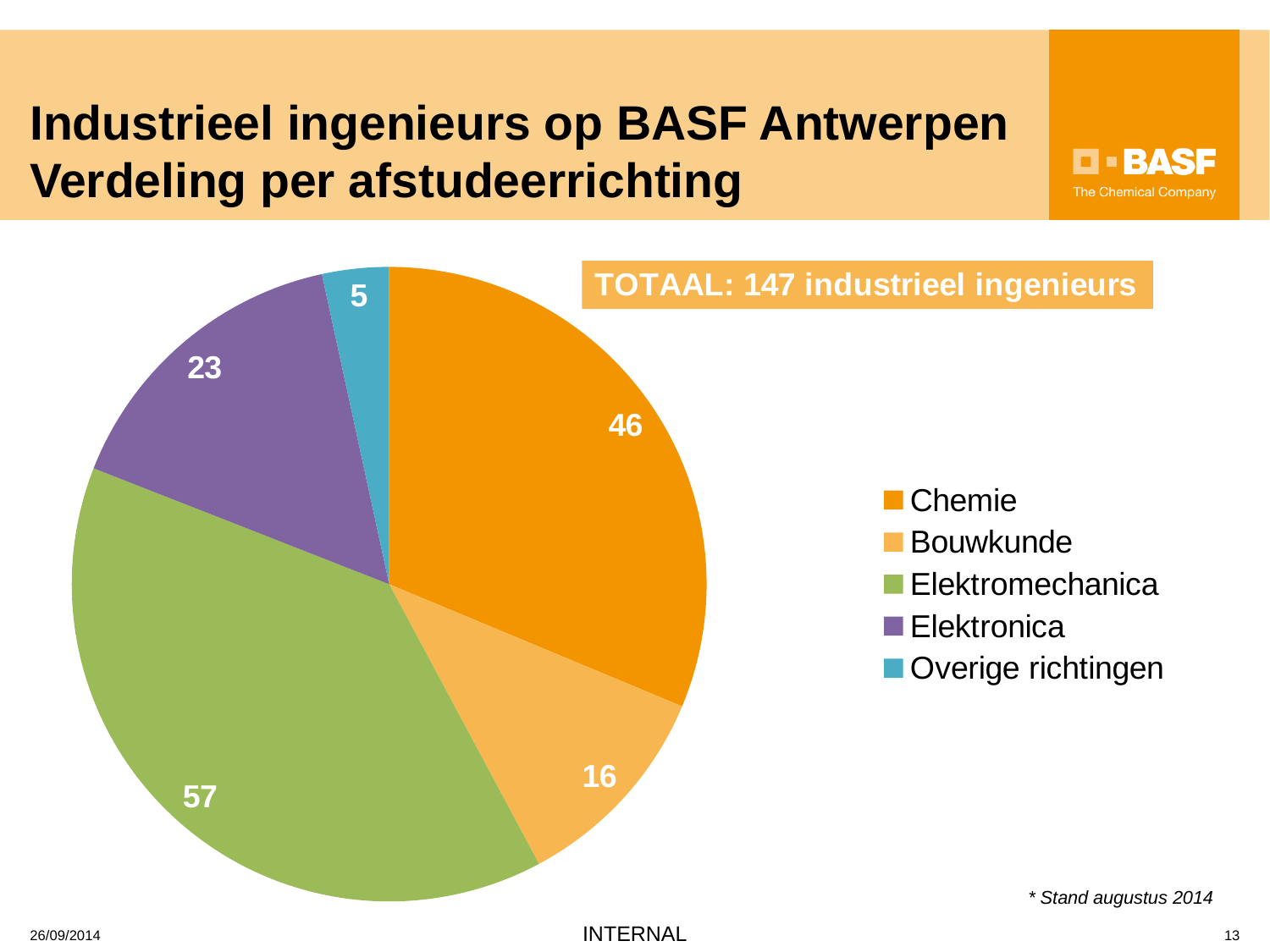
Which category has the smallest slice of the pie? Overige richtingen What is the difference between the Elektromechanica and Chemie values? 11 Which category has the largest slice of the pie? Elektromechanica What colour is the Elektronica slice in the pie chart? purple Which is larger, the Elektronica slice or the Bouwkunde slice? Elektronica What is the value shown for Bouwkunde? 16 What type of chart is shown on the slide? pie chart What is the value shown for Overige richtingen? 5 How many categories does the pie chart have? 5 What total number of industrial engineers is stated on the slide? 147 What is the value shown for Elektromechanica? 57 How many industrial engineers are in the Chemie slice? 46